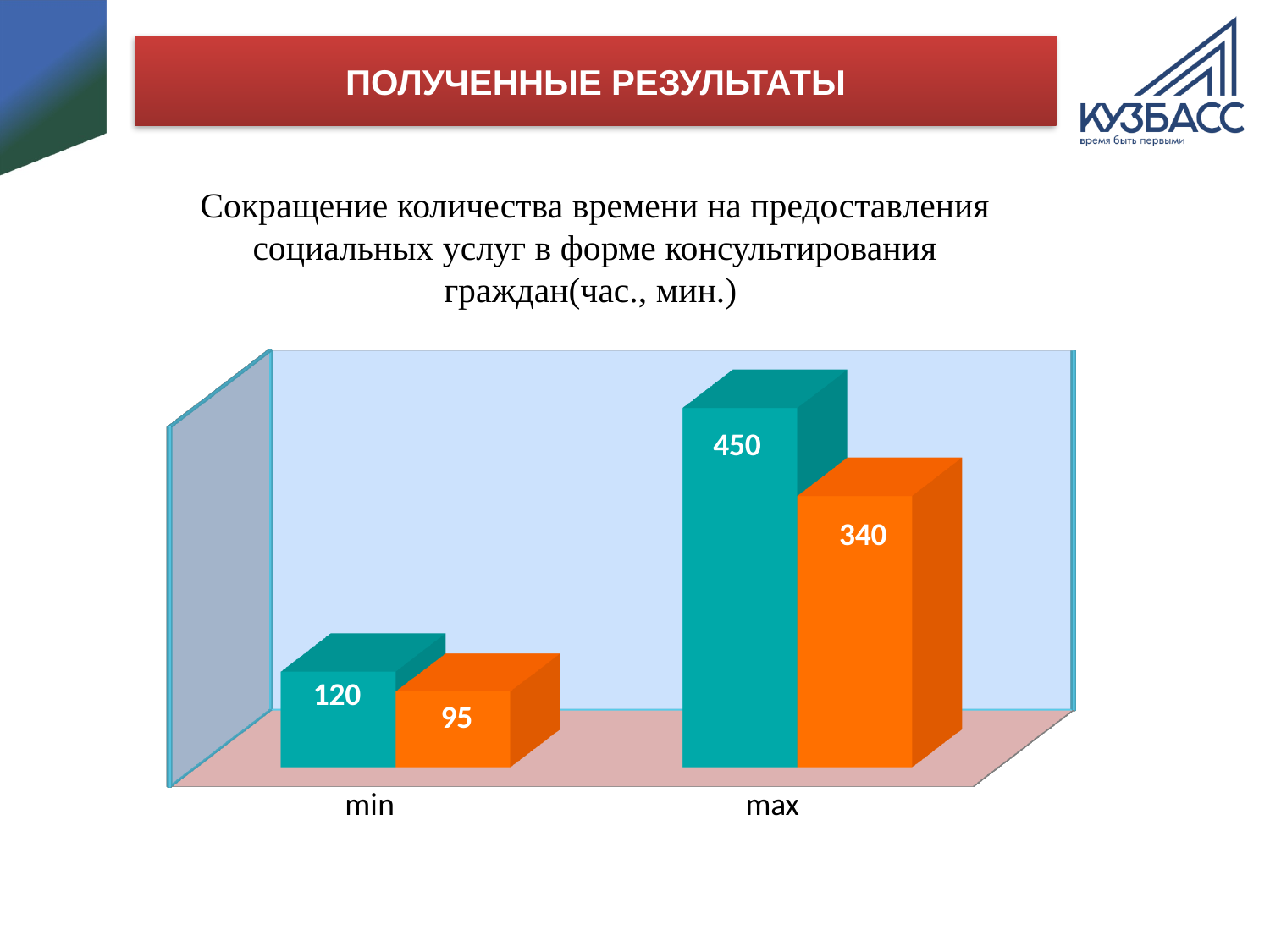
What is the difference between the teal and orange bars in the "max" category? 110 What is the difference between the teal and orange bars in the "min" category? 25 What kind of chart is shown on the slide? Bar chart Which bar has the lowest value on the chart? The orange bar for min (95) In the "max" category, which bar is larger, the teal one or the orange one? The teal one What is the value of the teal bar for the "min" category? 120 Which bar has the highest value on the chart? The teal bar for max (450) What are the two category labels on the x axis? min and max What is the value of the teal bar for the "max" category? 450 What is the value of the orange bar for the "min" category? 95 How many categories are shown on the x axis? 2 What is the value of the orange bar for the "max" category? 340